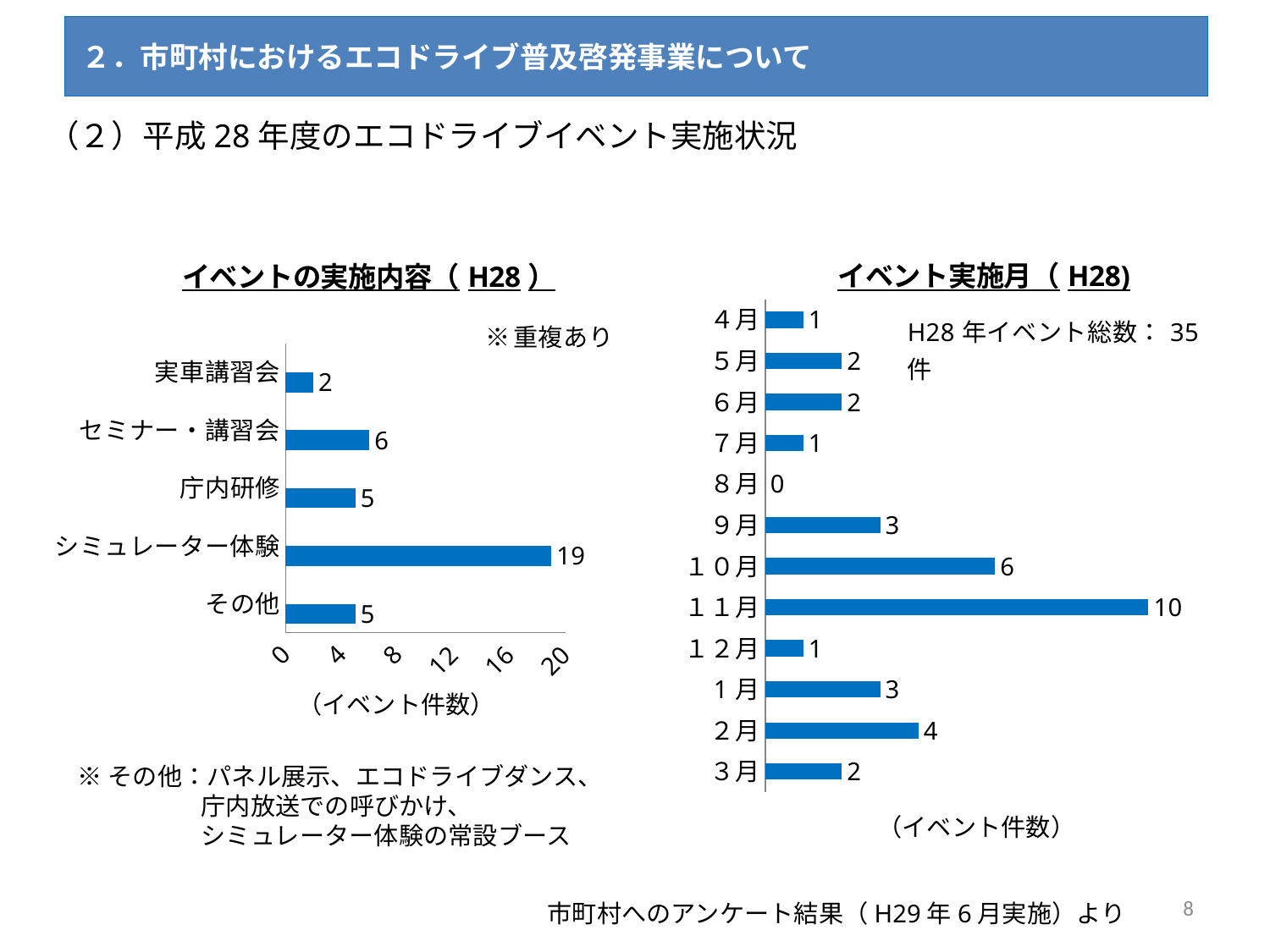
In the left chart (イベントの実施内容（H28）), how many categories are shown? 5 According to the text on the right chart, what is the total number of events in H28? 35件 In the left chart (イベントの実施内容（H28）), which category has the lowest value? 実車講習会 In the left chart (イベントの実施内容（H28）), what is the value for シミュレーター体験? 19 In the right chart (イベント実施月（H28）), which month has the lowest value? 8月 In the right chart (イベント実施月（H28）), what is the difference between 11月 and 12月? 9 In the right chart (イベント実施月（H28）), what is the value for 10月? 6 In the left chart (イベントの実施内容（H28）), what kind of chart is it? bar chart In the right chart (イベント実施月（H28）), which is larger, the value for 2月 or the value for 9月? 2月 In the right chart (イベント実施月（H28）), how many months are shown? 12 In the right chart (イベント実施月（H28）), which month has the highest value? 11月 In the left chart (イベントの実施内容（H28）), what is the difference between シミュレーター体験 and セミナー・講習会? 13